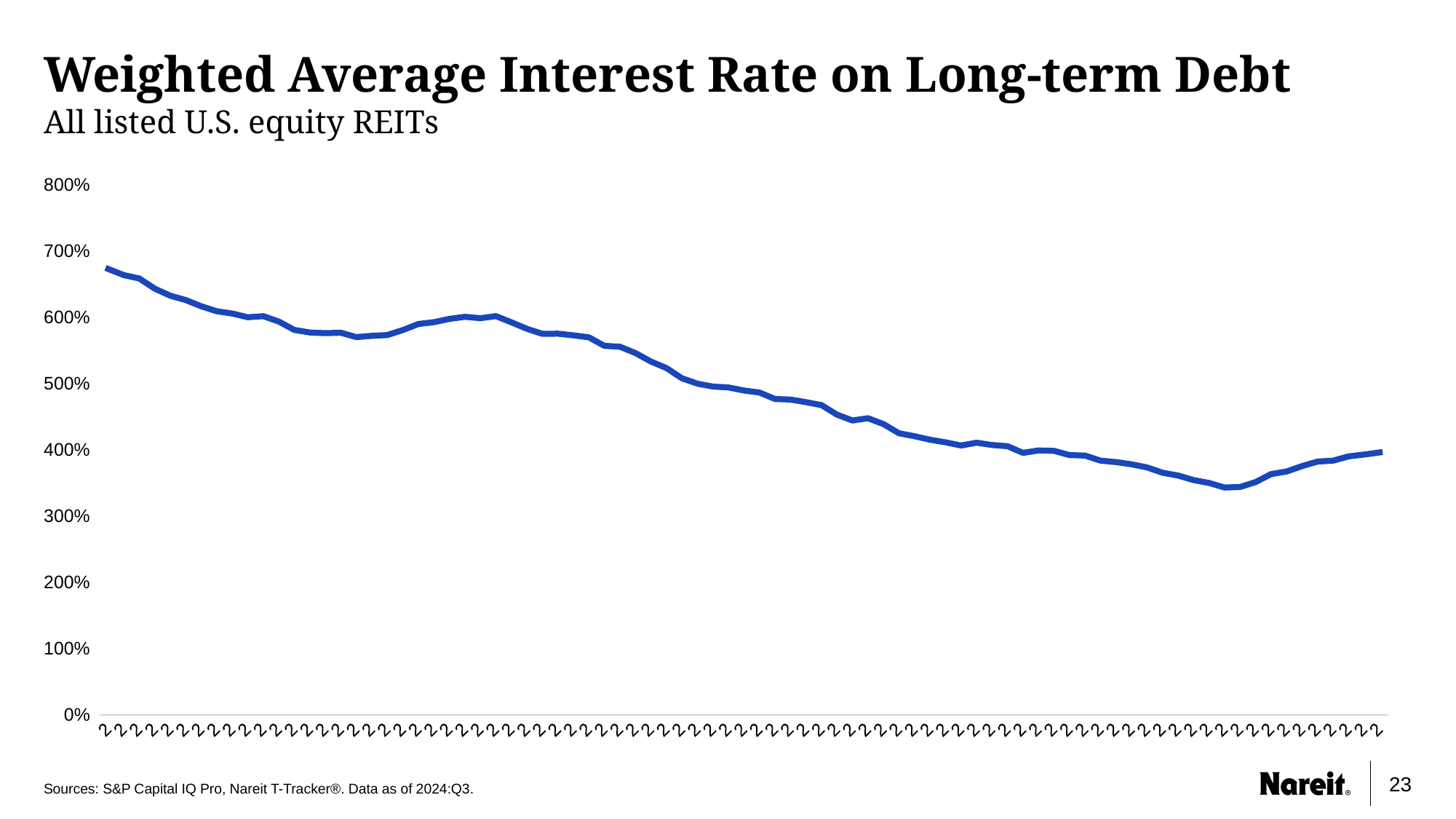
What kind of chart is shown on the slide? line chart What is the title of the chart on the slide? Weighted Average Interest Rate on Long-term Debt What is the highest value shown on the vertical axis? 800% Is the lowest point of the line greater or less than 400%? less Which is larger, the value at the leftmost point of the line or the value at the rightmost point? the leftmost point What subtitle appears under the chart title? All listed U.S. equity REITs Is the value at the leftmost point of the line greater or less than 600%? greater Is the lowest point of the line greater or less than 300%? greater Overall, does the line rise or fall from left to right across the chart? fall